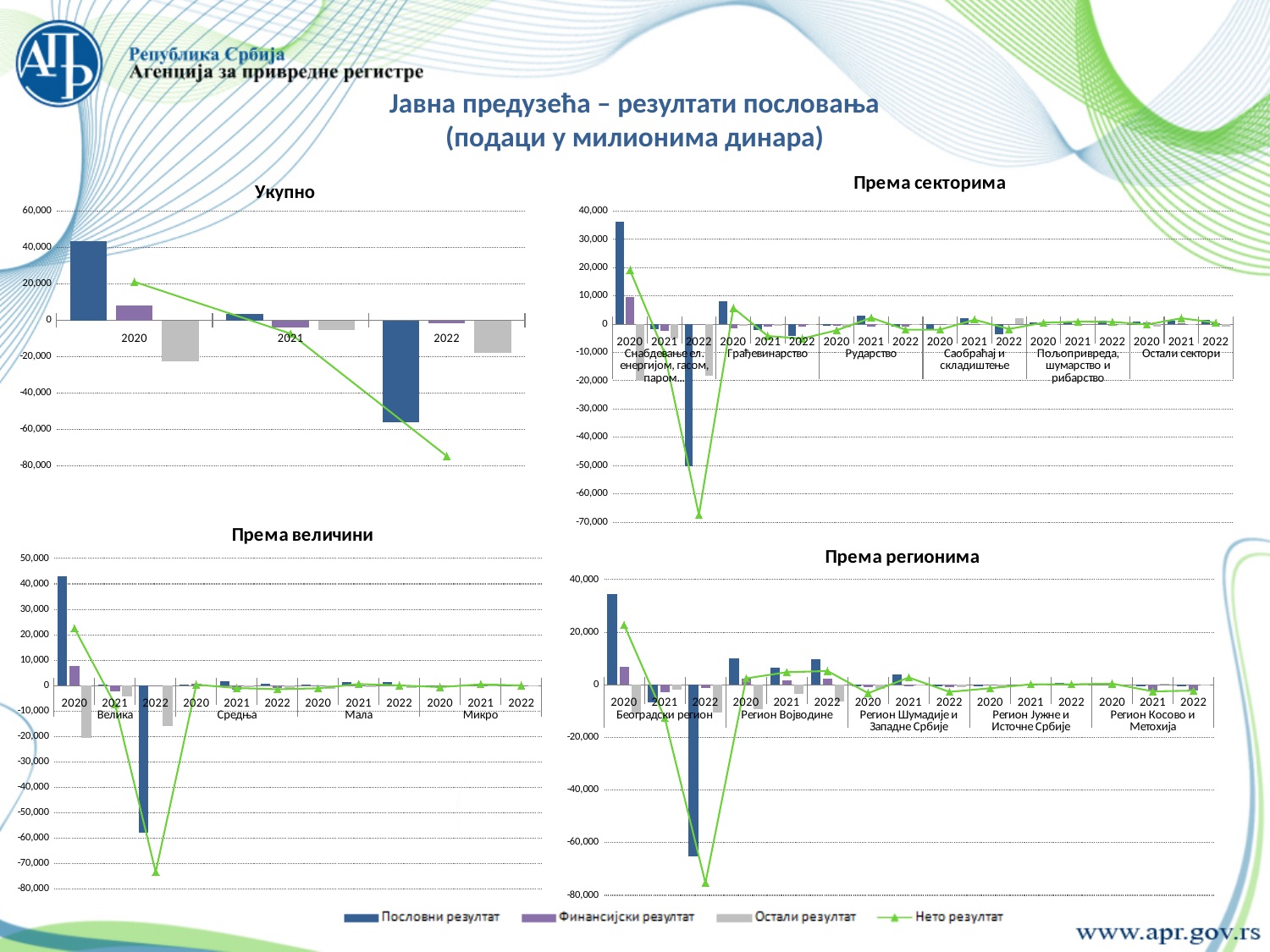
In the 'Укупно' chart, does the Нето резултат line rise or fall from 2020 to 2022? fall How many size categories are shown on the x axis of the 'Према величини' chart? 4 In the 'Према регионима' chart, is the Пословни резултат for Београдски регион in 2022 greater or less than -60,000? less In the 'Према секторима' chart, is the Пословни резултат for Снабдевање ел. енергијом, гасом, паром in 2020 greater or less than 30,000? greater How many series does the shared legend at the bottom of the slide list? 4 In the 'Укупно' chart, is the Пословни резултат for 2020 greater or less than 40,000? greater In the 'Према величини' chart, which is larger: the Пословни резултат for Велика in 2020 or for Средња in 2020? Велика in 2020 In the 'Укупно' chart, which year has the highest Пословни резултат? 2020 How many sectors are shown on the x axis of the 'Према секторима' chart? 6 What kind of chart is the 'Укупно' chart? bar chart with a line In the 'Укупно' chart, which year has the lowest Нето резултат? 2022